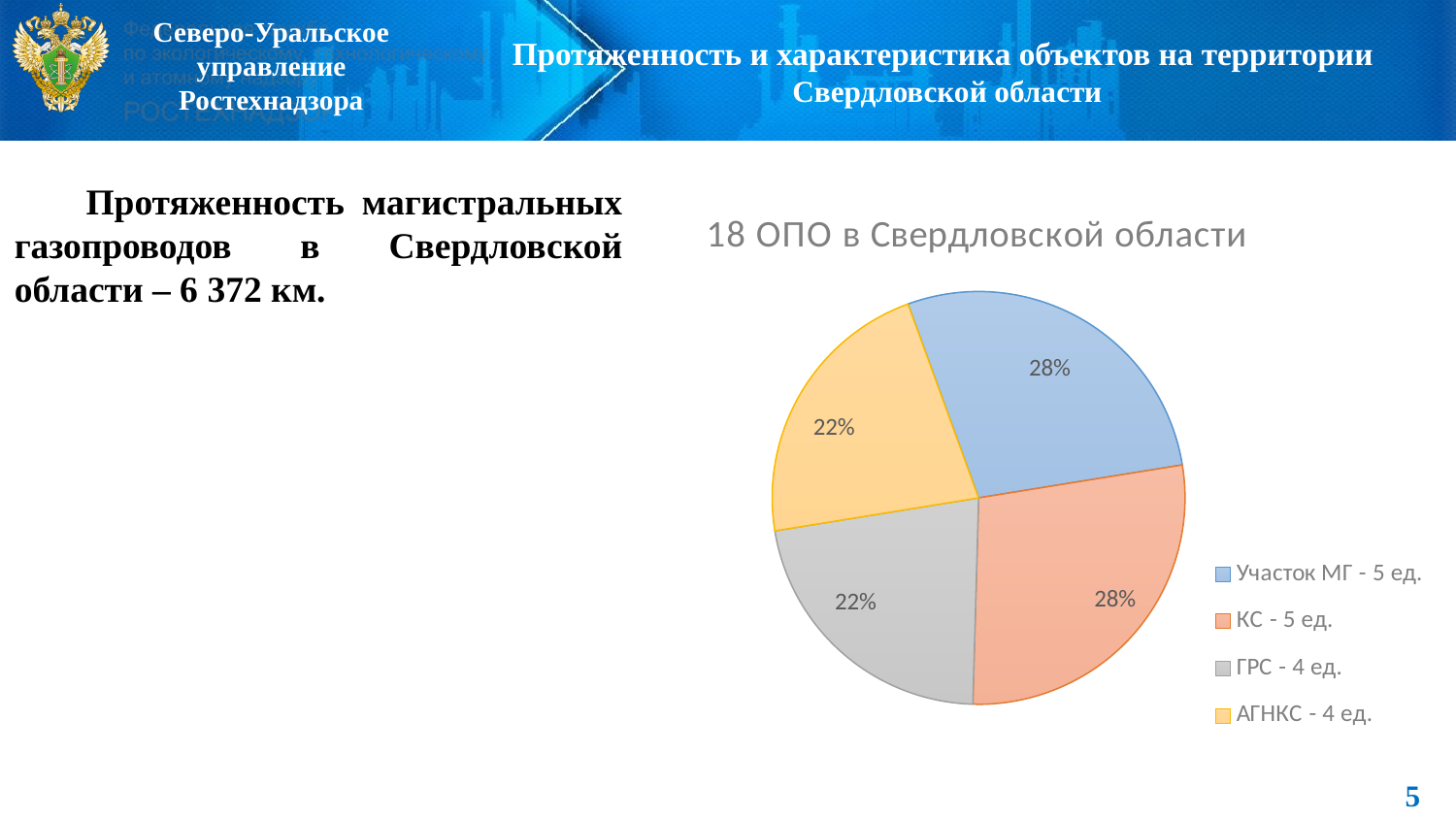
How many slices does the pie chart have? 4 How many entries does the legend of the pie chart list? 4 What is the title of the pie chart? 18 ОПО в Свердловской области What share of the pie does the slice for АГНКС - 4 ед. represent? 22% According to the legend, how many units (ед.) are listed for ГРС? 4 ед. What share of the pie does the slice for ГРС - 4 ед. represent? 22% Which legend entry is shown in yellow? АГНКС - 4 ед. What share of the pie does the slice for Участок МГ - 5 ед. represent? 28% Which slice is larger: Участок МГ - 5 ед. or ГРС - 4 ед.? Участок МГ - 5 ед. What kind of chart is shown on the slide? pie chart What is the difference in percentage points between the КС - 5 ед. slice and the АГНКС - 4 ед. slice? 6 percentage points